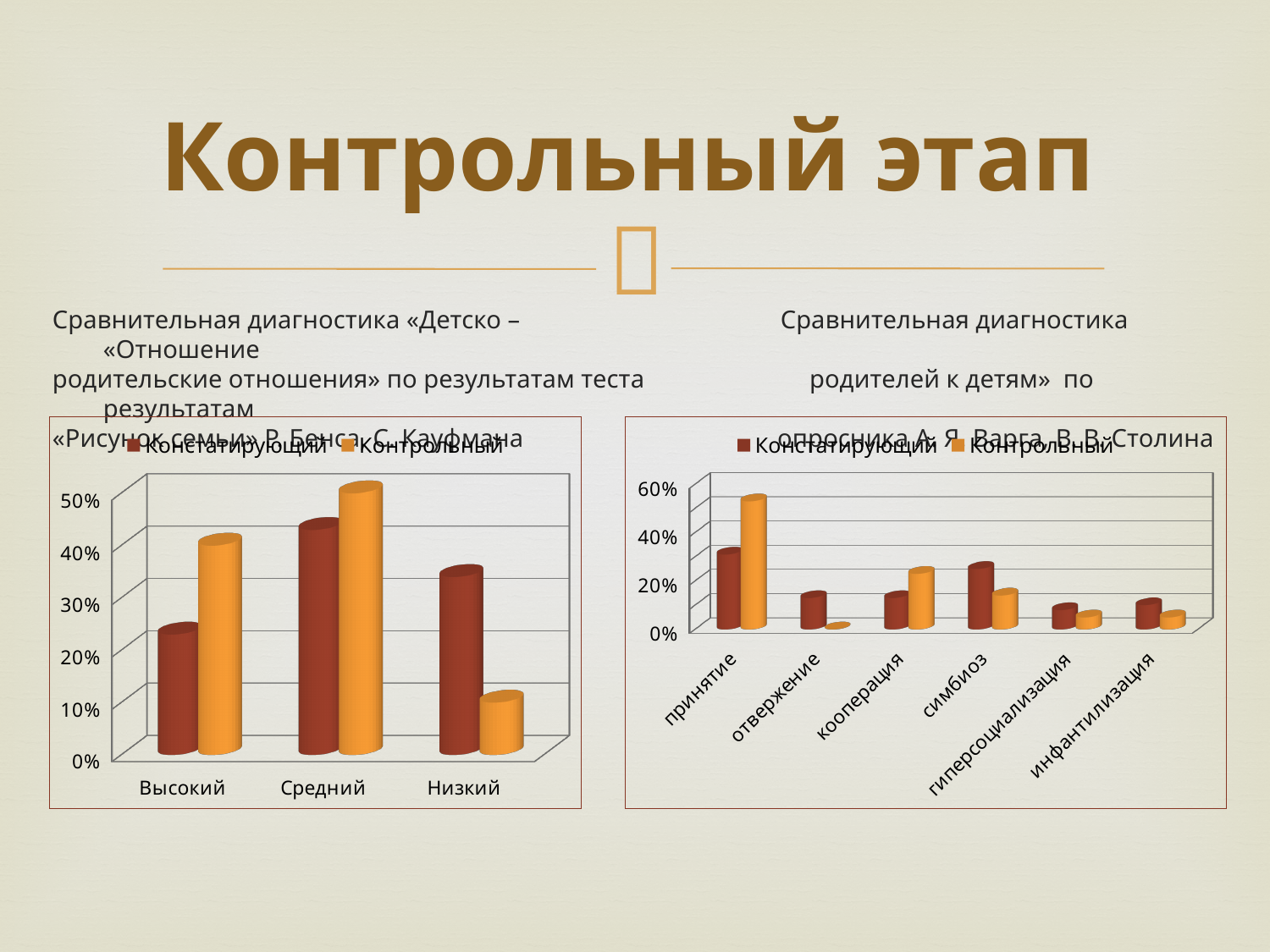
On the left chart, is the Контрольный value for Высокий greater or less than 30%? greater On the right chart, which category has the highest value for the Контрольный series? принятие On the left chart, how many series does the legend list? 2 On the right chart, is the Контрольный value for принятие greater or less than 40%? greater On the right chart, how many categories are shown on the x axis? 6 On the right chart, for the симбиоз category, which series is larger: Констатирующий or Контрольный? Констатирующий On the left chart, which category has the lowest value for the Контрольный series? Низкий On the left chart, how many categories are shown on the x axis? 3 What kind of chart is the right chart? bar chart On the left chart, which category has the highest value for the Контрольный series? Средний On the right chart, what are the two legend entries? Констатирующий and Контрольный On the left chart, for the Низкий category, which series is larger: Констатирующий or Контрольный? Констатирующий